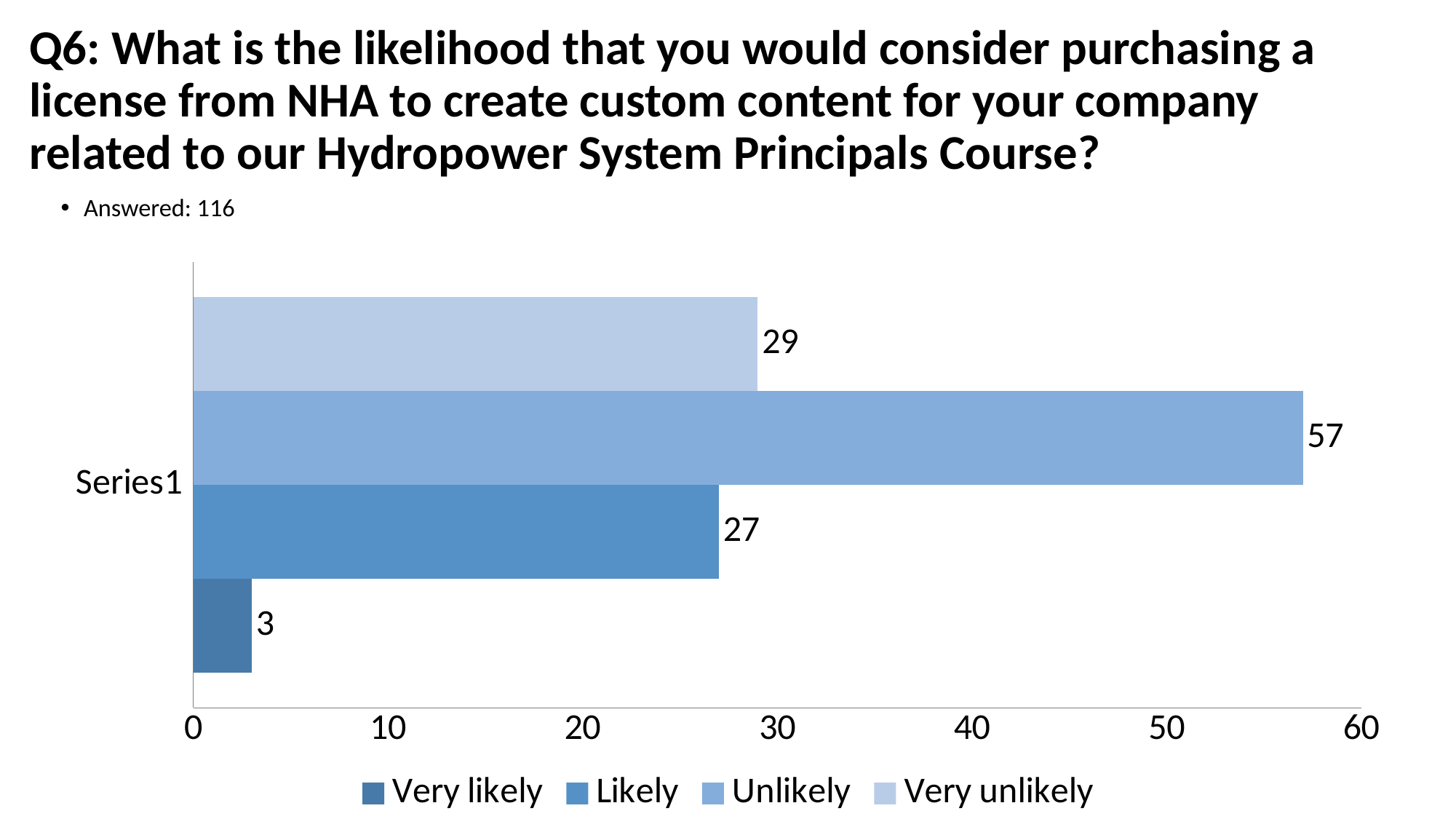
What is the value for Unlikely? 57 What is the value for Likely? 27 What is the total of the four values shown in the chart? 116 What is the value for Very unlikely? 29 Which response option has the highest value? Unlikely What is the difference between the values for Unlikely and Very unlikely? 28 Which is larger, the value for Likely or the value for Very unlikely? Very unlikely Which response option has the lowest value? Very likely What is the value for Very likely? 3 What kind of chart is shown on the slide? bar chart How many series does the legend list? 4 Is the value for Unlikely greater or less than 50? greater